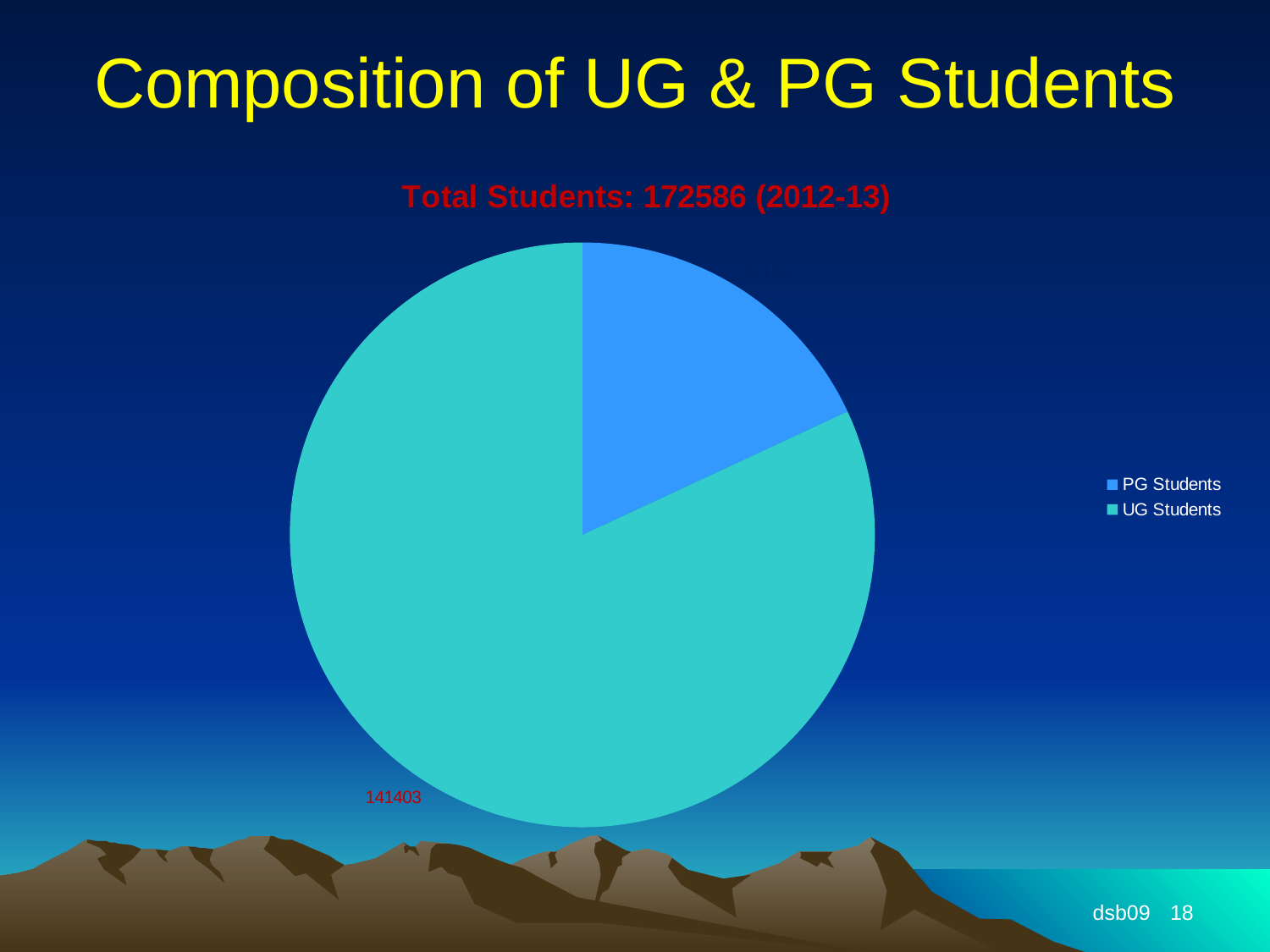
What is the title of the chart? Total Students: 172586 (2012-13) Which category has the smallest slice of the pie? PG Students What is the value shown for UG Students? 141403 Which category has the largest slice of the pie? UG Students What colour is the slice for PG Students? Blue How many slices does the pie chart have? 2 Which is larger, the slice for UG Students or the slice for PG Students? UG Students Which academic year does the chart title refer to? 2012-13 How many categories does the legend list? 2 What kind of chart is shown on the slide? Pie chart